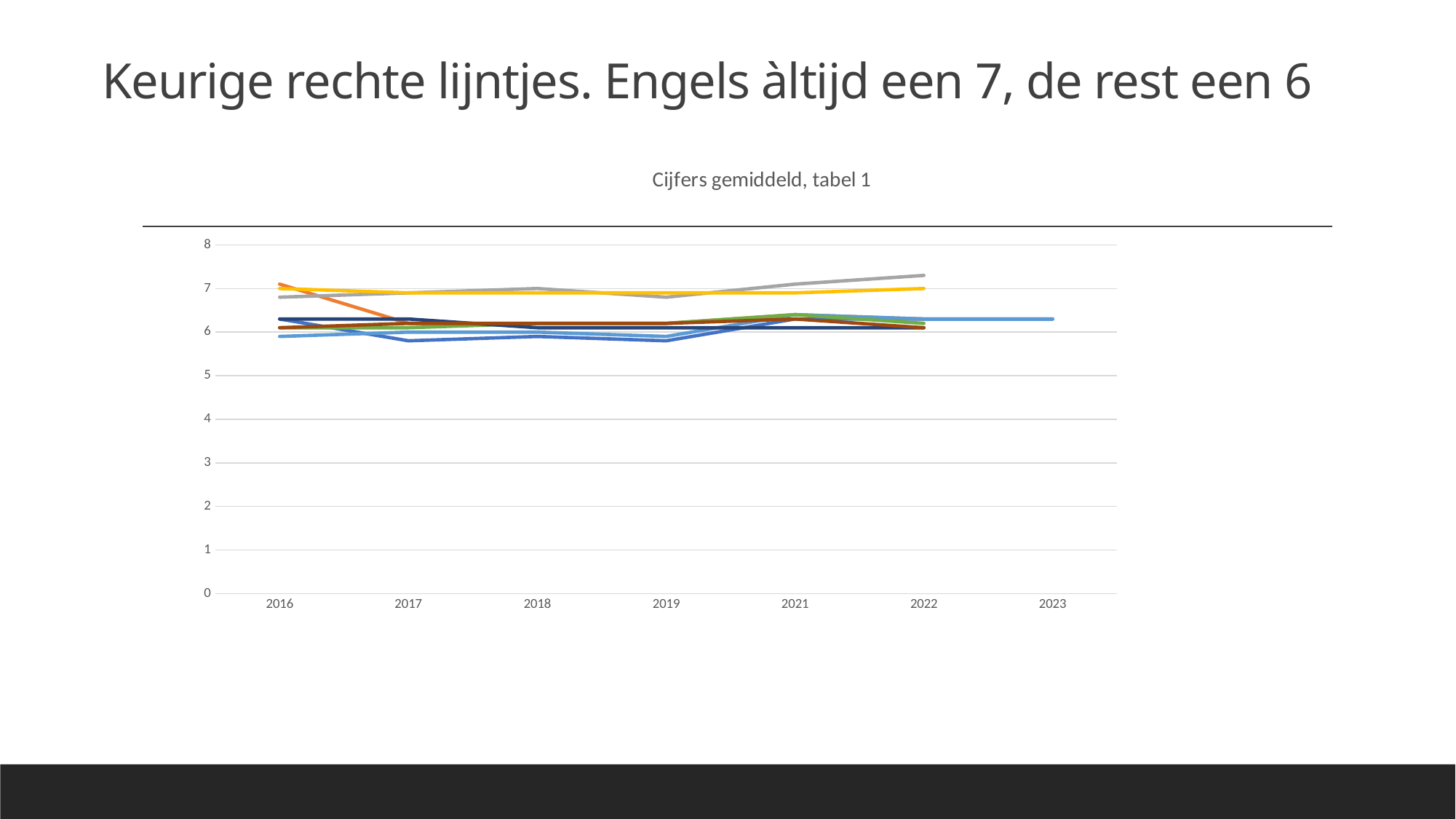
What is the first year shown on the x axis? 2016 Is the value of the lowest line in 2017 greater or less than 6? less What is the highest value shown on the y axis? 8 What kind of chart is shown on the slide? line chart Is the value of the gray line in 2022 greater or less than 7? greater How many years are labelled on the x axis of the chart? 7 Which year between 2019 and 2022 is missing from the x axis? 2020 Does the gray line rise or fall from 2019 to 2022? rise What is the title of the chart? Cijfers gemiddeld, tabel 1 Are the values of all lines in 2019 greater or less than 5? greater